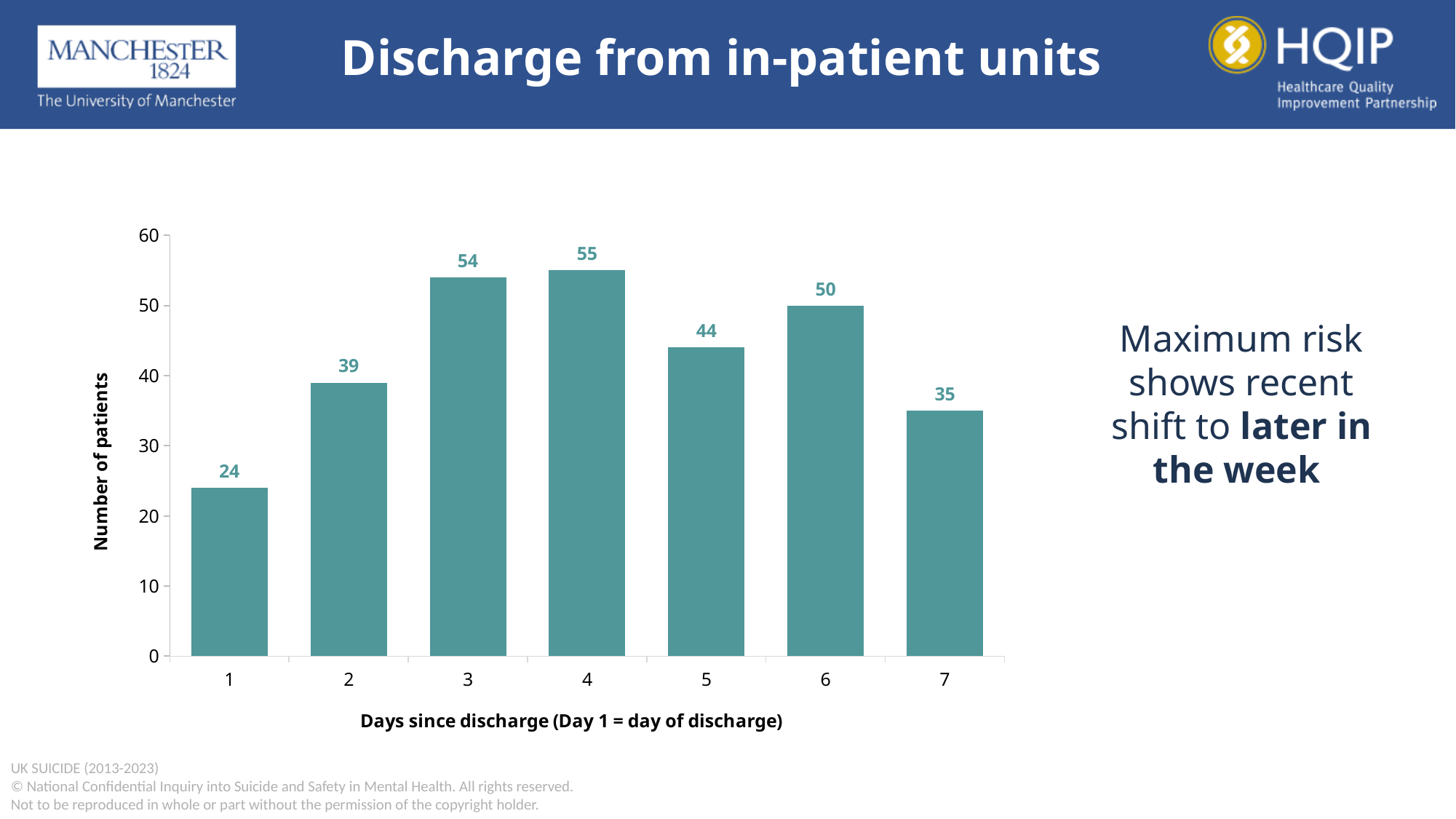
Is the number of patients for day 3 greater or less than 50? greater Which has more patients, day 2 or day 5? Day 5 How many days since discharge are shown on the x axis? 7 Which day since discharge has the lowest number of patients? 1 What kind of chart is shown on the slide? Bar chart Which day since discharge has the highest number of patients? 4 What is the number of patients for day 4 since discharge? 55 What is the difference in number of patients between day 4 and day 1? 31 What is the difference in number of patients between day 6 and day 7? 15 What is the label of the y axis? Number of patients What is the number of patients for day 7 since discharge? 35 What is the number of patients for day 1 since discharge? 24